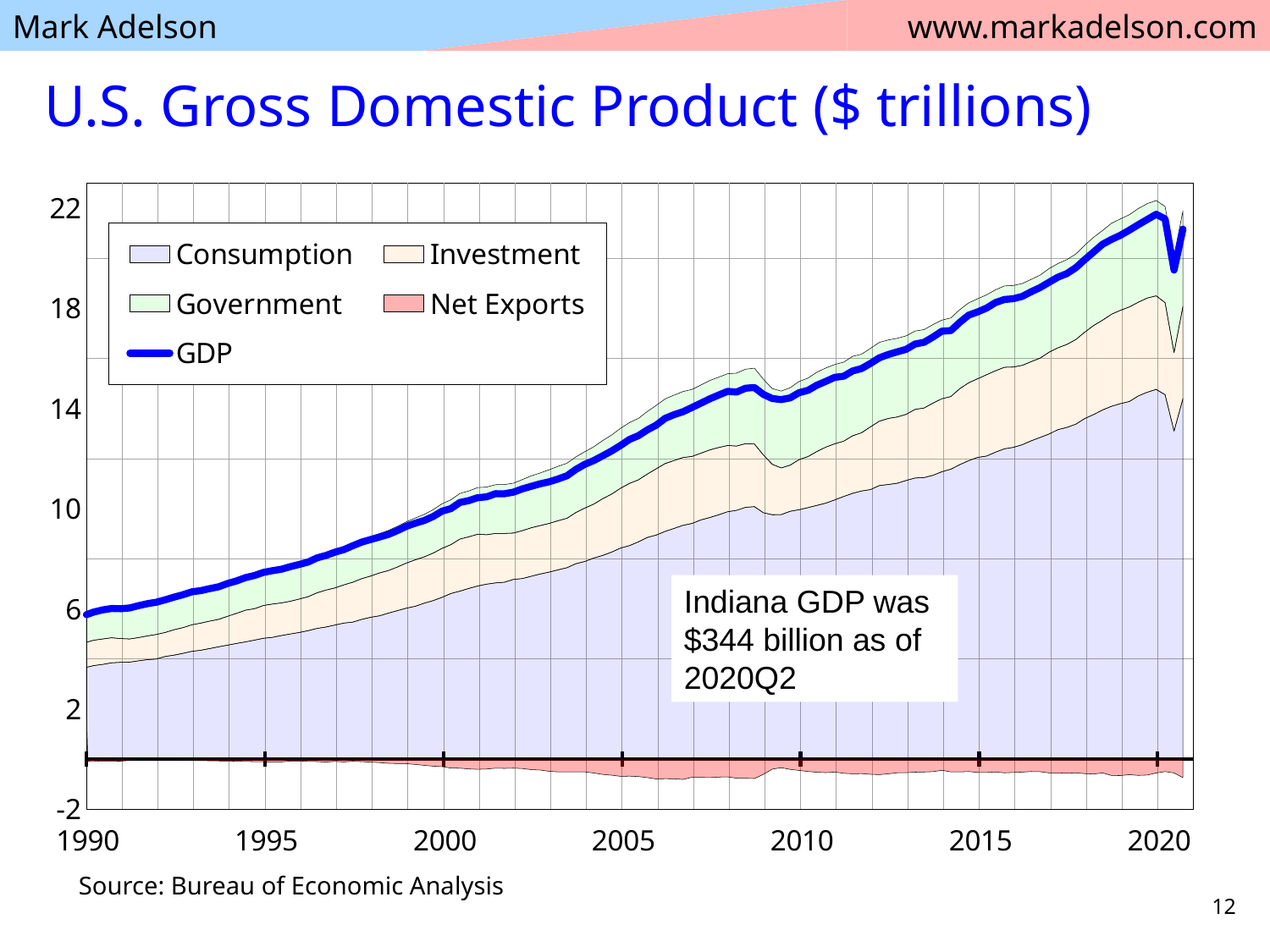
Which series is plotted below zero for most of the period after 2000? Net Exports Is the GDP value in 2005 greater or less than 14? less What is the source cited below the chart? Bureau of Economic Analysis In which year shown on the x axis is GDP lowest? 1990 Is the GDP value in 1995 greater or less than 6? greater Which is larger in 2015, Consumption or Government? Consumption Does the GDP line generally rise or fall from 1990 to 2020? Rise How many series does the legend list? 5 Is the GDP value in 2010 greater or less than 14? greater What kind of chart is shown on the slide? Stacked area chart with a line What is the title of the chart? U.S. Gross Domestic Product ($ trillions)